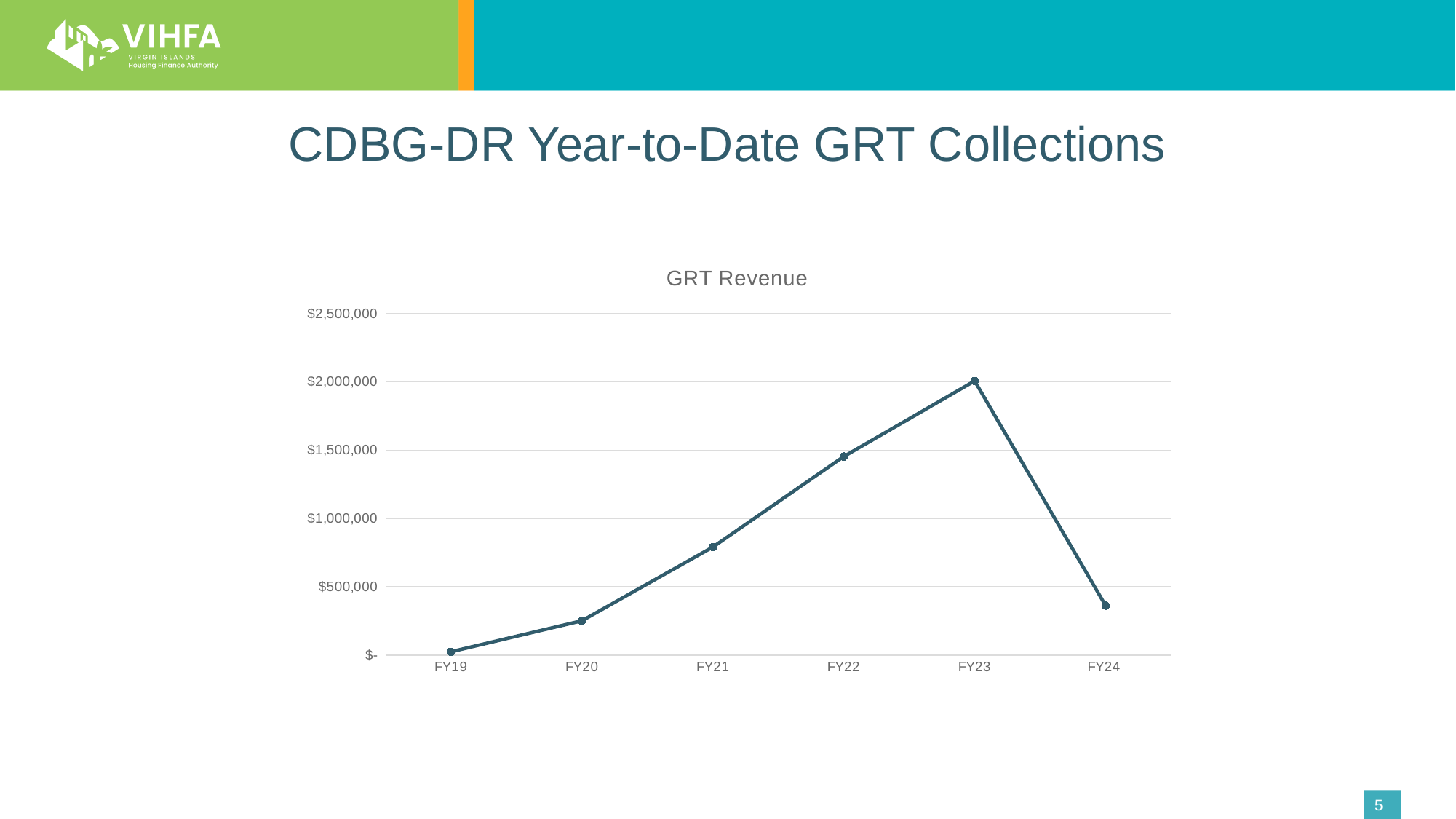
Do the values rise or fall from FY19 to FY23? rise Which is larger, the value for FY22 or the value for FY24? FY22 Which fiscal year has the lowest GRT revenue? FY19 How many fiscal years are plotted on the x axis? 6 Is the value for FY24 greater or less than $500,000? less Which fiscal year has the highest GRT revenue? FY23 Which is larger, the value for FY21 or the value for FY20? FY21 Is the value for FY22 greater or less than $1,000,000? greater What is the title of the chart? GRT Revenue Is the value for FY21 greater or less than $500,000? greater What kind of chart is shown on the slide? line chart